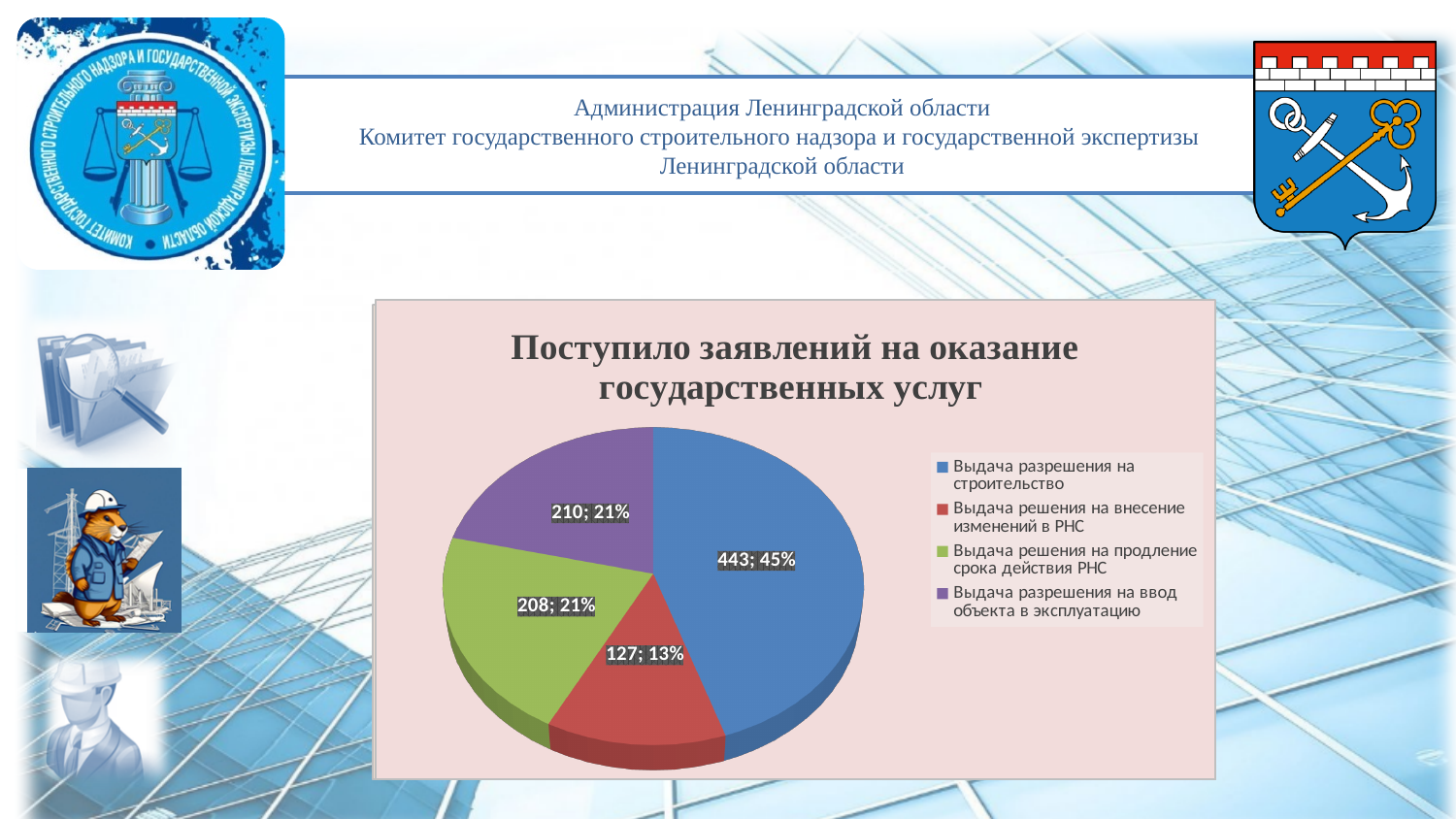
What share of the pie does "Выдача разрешения на ввод объекта в эксплуатацию" represent? 21% How many slices does the pie chart have? 4 What is the difference between the number of applications for "Выдача разрешения на строительство" and "Выдача решения на внесение изменений в РНС"? 316 What is the title of the chart? Поступило заявлений на оказание государственных услуг How many entries does the legend list? 4 Which category has the smallest slice? Выдача решения на внесение изменений в РНС How many applications are shown for "Выдача разрешения на строительство"? 443 How many applications are shown for "Выдача решения на продление срока действия РНС"? 208 Which category has the largest slice? Выдача разрешения на строительство What share of the pie does "Выдача разрешения на строительство" represent? 45% How many applications are shown for "Выдача решения на внесение изменений в РНС"? 127 What kind of chart is shown on the slide? pie chart